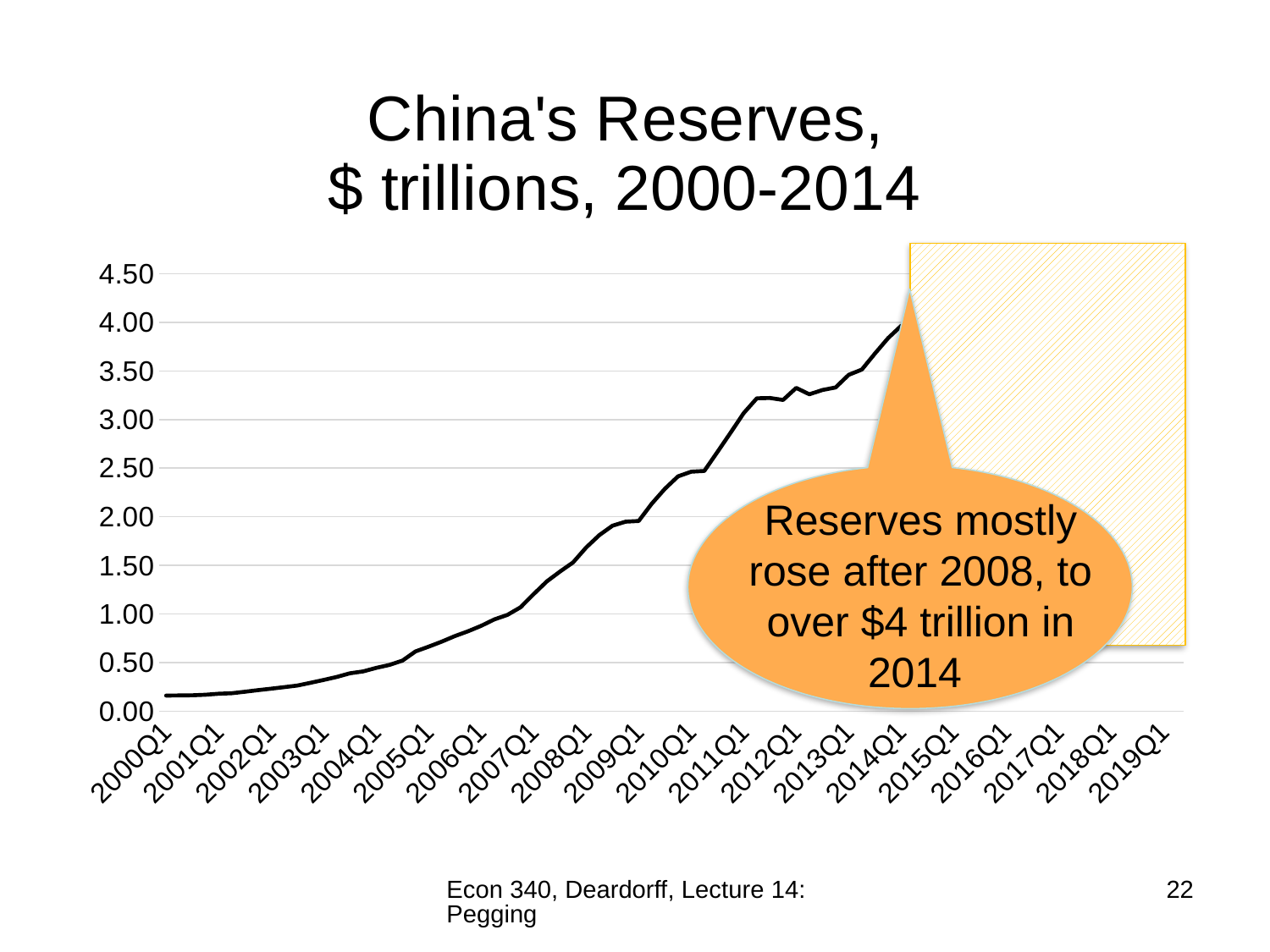
Do China's reserves rise or fall over the period plotted from 2000Q1 to 2014Q1? rise What is the highest tick value shown on the vertical axis? 4.50 Is the value for 2008Q1 greater or less than 1.00? greater Is the value for 2006Q1 greater or less than 0.50? greater Is the value for 2012Q1 greater or less than 3.00? greater What is the title of the chart? China's Reserves, $ trillions, 2000-2014 What kind of chart is shown on the slide? line chart Which is larger, the value for 2007Q1 or the value for 2011Q1? 2011Q1 At which quarter label is the plotted line at its lowest? 2000Q1